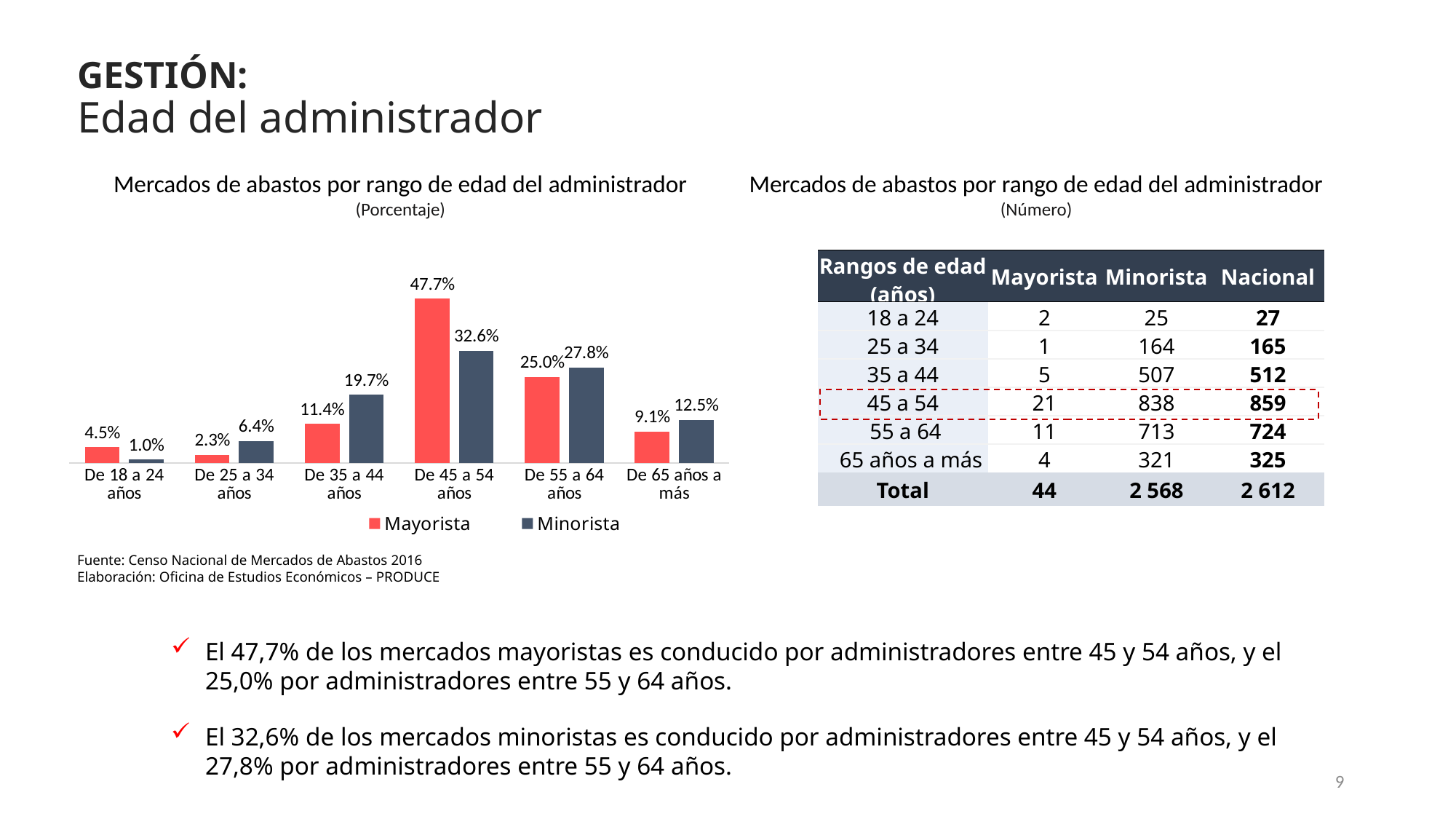
For De 18 a 24 años, which series has the larger value, Mayorista or Minorista? Mayorista What is the difference between the Mayorista and Minorista values for De 45 a 54 años? 15.1% What is the Minorista value for De 35 a 44 años? 19.7% For De 55 a 64 años, which series has the larger value, Mayorista or Minorista? Minorista What colour are the Mayorista bars in the chart? red What is the Mayorista value for De 45 a 54 años? 47.7% How many series does the chart legend list? 2 Which age range has the highest Minorista value? De 45 a 54 años Which age range has the lowest Mayorista value? De 25 a 34 años How many age range categories are shown on the x axis of the chart? 6 What is the Mayorista value for De 65 años a más? 9.1% What type of chart is shown on the slide? bar chart